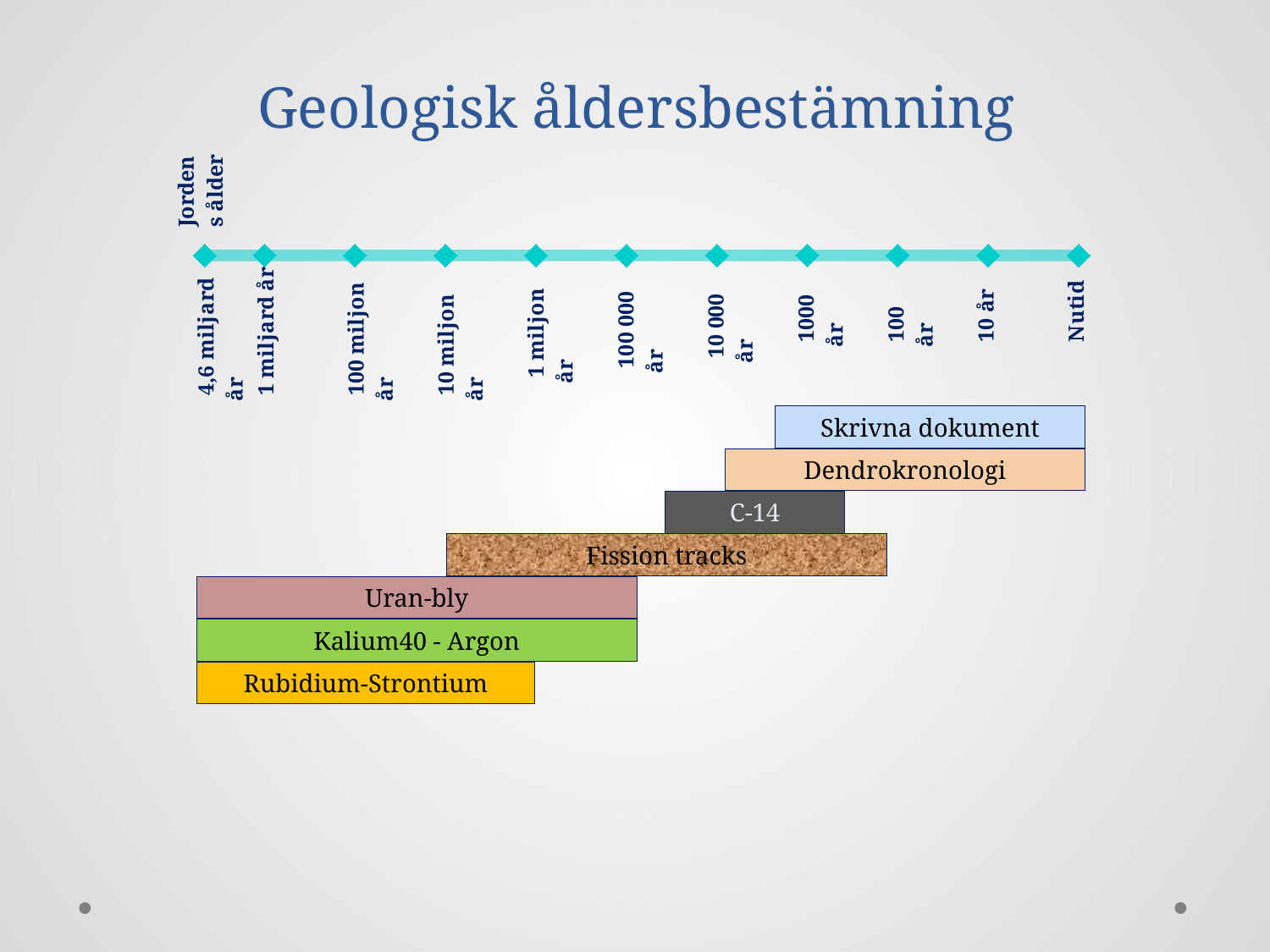
What is the label of the rightmost marker on the timeline? Nutid What is the title of the slide chart? Geologisk åldersbestämning Which dating-method bar is placed at the top of the stack? Skrivna dokument Which dating-method bar is placed at the bottom of the stack? Rubidium-Strontium How many dating-method bars are shown below the timeline? 7 Which dating-method bar is the shortest? C-14 Which timeline label lies between 1 miljon år and 10 000 år? 100 000 år What label is written above the leftmost marker of the timeline? Jordens ålder What is the label of the leftmost marker on the timeline? 4,6 miljard år How many diamond markers are on the timeline? 11 Which bar is longer, Uran-bly or Rubidium-Strontium? Uran-bly Which dating-method bar starts at the 10 miljon år marker? Fission tracks